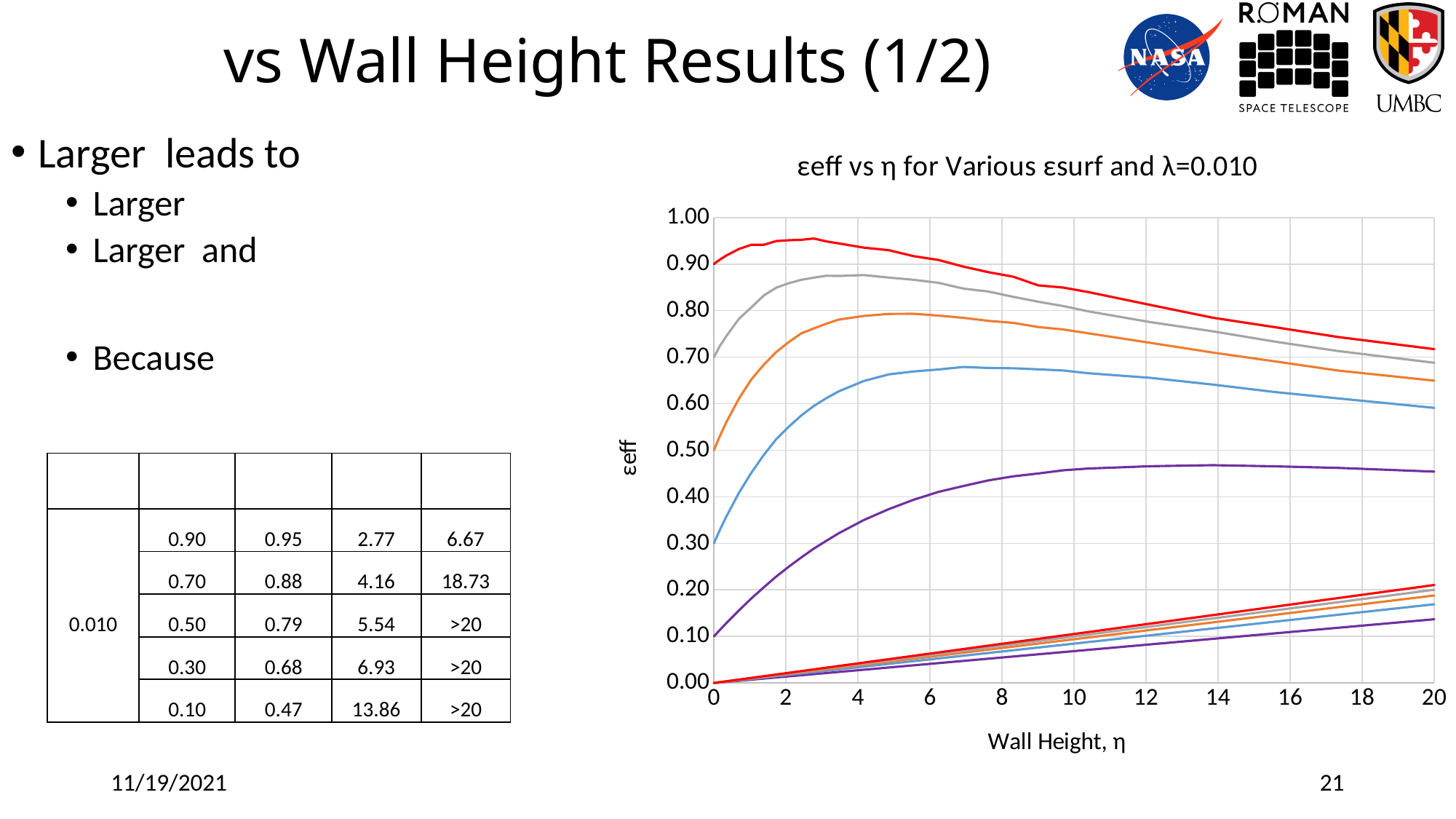
Which colour curve reaches the highest εeff value on the chart? red What is the label of the x axis of the chart? Wall Height, η Do the lines in the lower group of the chart rise or fall as wall height increases from 0 to 20? rise Is the value of the blue upper curve at wall height 20 greater or less than 0.70? less What is the largest wall height value shown on the x axis of the chart? 20 What is the title of the chart? εeff vs η for Various εsurf and λ=0.010 Is the peak value of the purple upper curve greater or less than 0.50? less Does the red curve rise or fall as wall height increases from 10 to 20? fall What kind of chart is shown on the slide? line chart What is the highest value shown on the y axis of the chart? 1.00 Is the peak value of the red curve greater or less than 0.90? greater At wall height 20, is the red upper curve or the purple upper curve higher? red